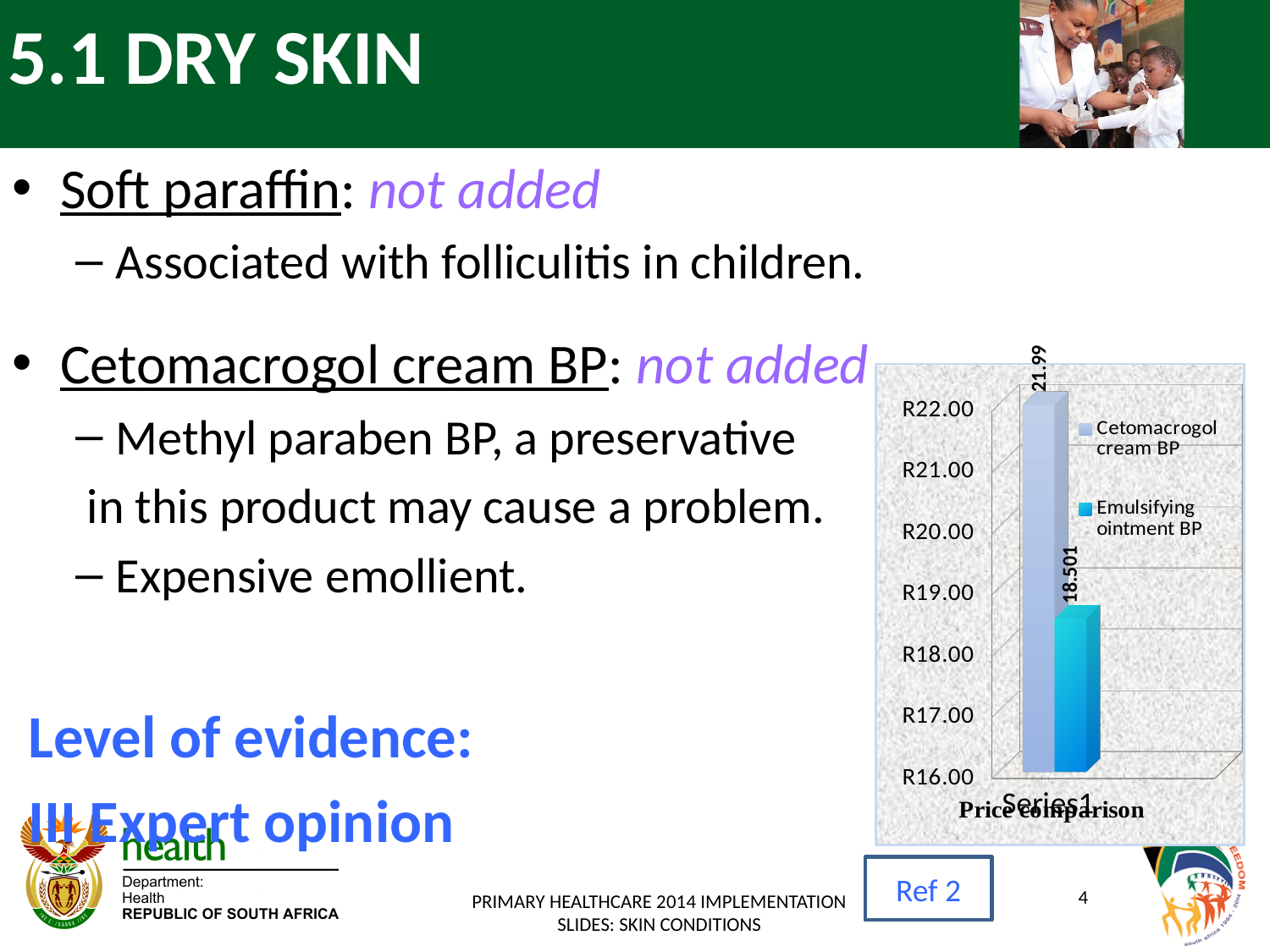
What is the title of the chart? Price comparison What kind of chart is shown on the slide? Bar chart How many series does the legend list? 2 Which series has the higher value, Cetomacrogol cream BP or Emulsifying ointment BP? Cetomacrogol cream BP What is the lowest value shown on the chart's vertical axis? R16.00 What is the difference between the values for Cetomacrogol cream BP and Emulsifying ointment BP? 3.489 What is the value shown for Emulsifying ointment BP? 18.501 Is the value for Cetomacrogol cream BP greater or less than R21.00? greater Is the value for Emulsifying ointment BP greater or less than R19.00? less Which series has the lowest value in the chart? Emulsifying ointment BP What is the value shown for Cetomacrogol cream BP? 21.99 Which series has the highest value in the chart? Cetomacrogol cream BP